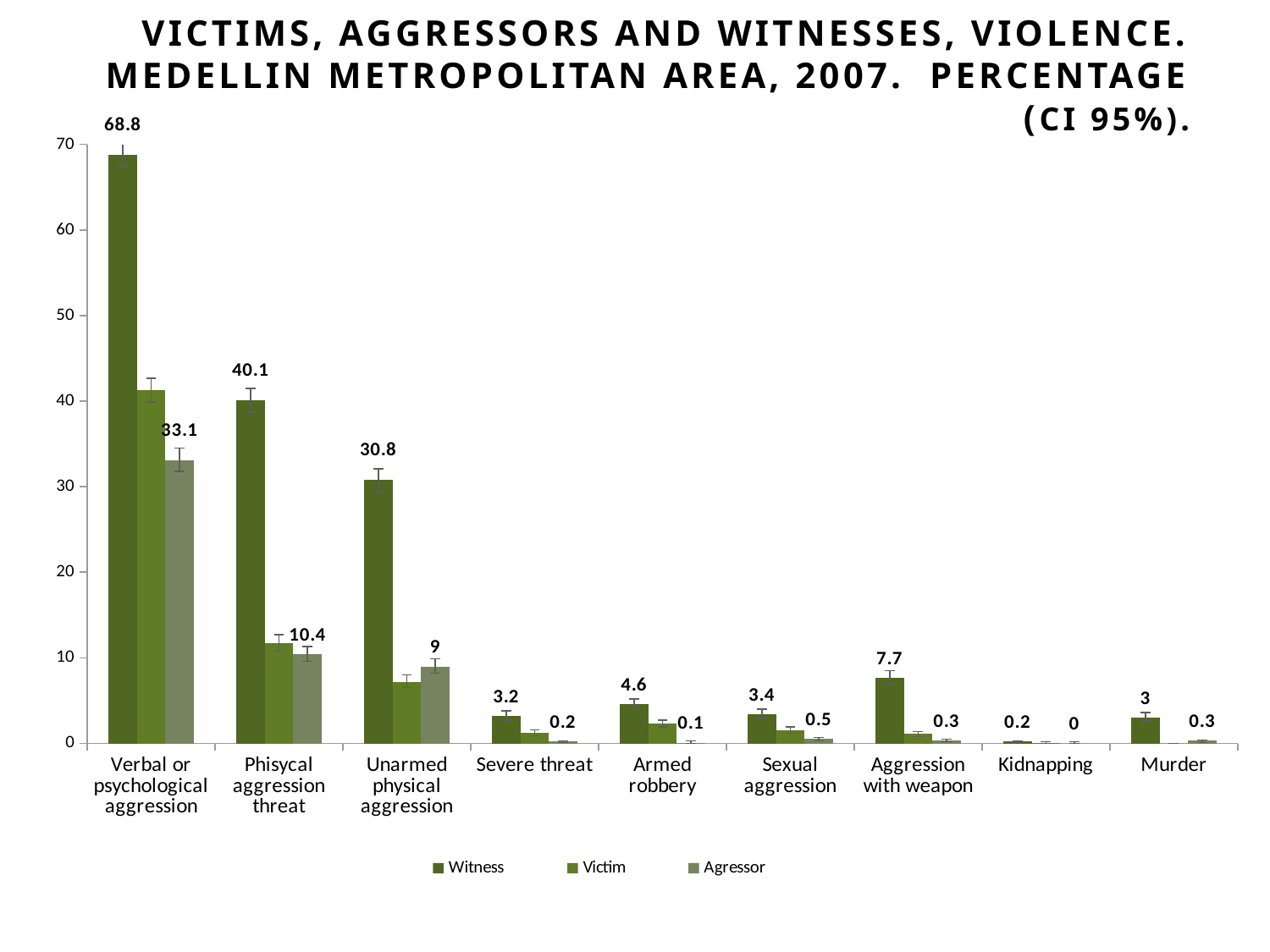
What is the Agressor value for Phisycal aggression? 10.4 Is the Victim value for Verbal or psychological aggression greater or less than 40? greater What is the Agressor value for Kidnapping? 0 Which category has the highest Witness value? Verbal or psychological aggression What kind of chart is shown on the slide? Bar chart How many series does the legend list? 3 How many categories are shown on the x axis? 9 What is the Witness value for Aggression with weapon? 7.7 Which category has the lowest Witness value? Kidnapping What is the difference between the Witness and Agressor values for Unarmed physical aggression? 21.8 What is the Witness value for Verbal or psychological aggression? 68.8 Which is larger: the Witness value for Armed robbery or the Witness value for Sexual aggression? Armed robbery